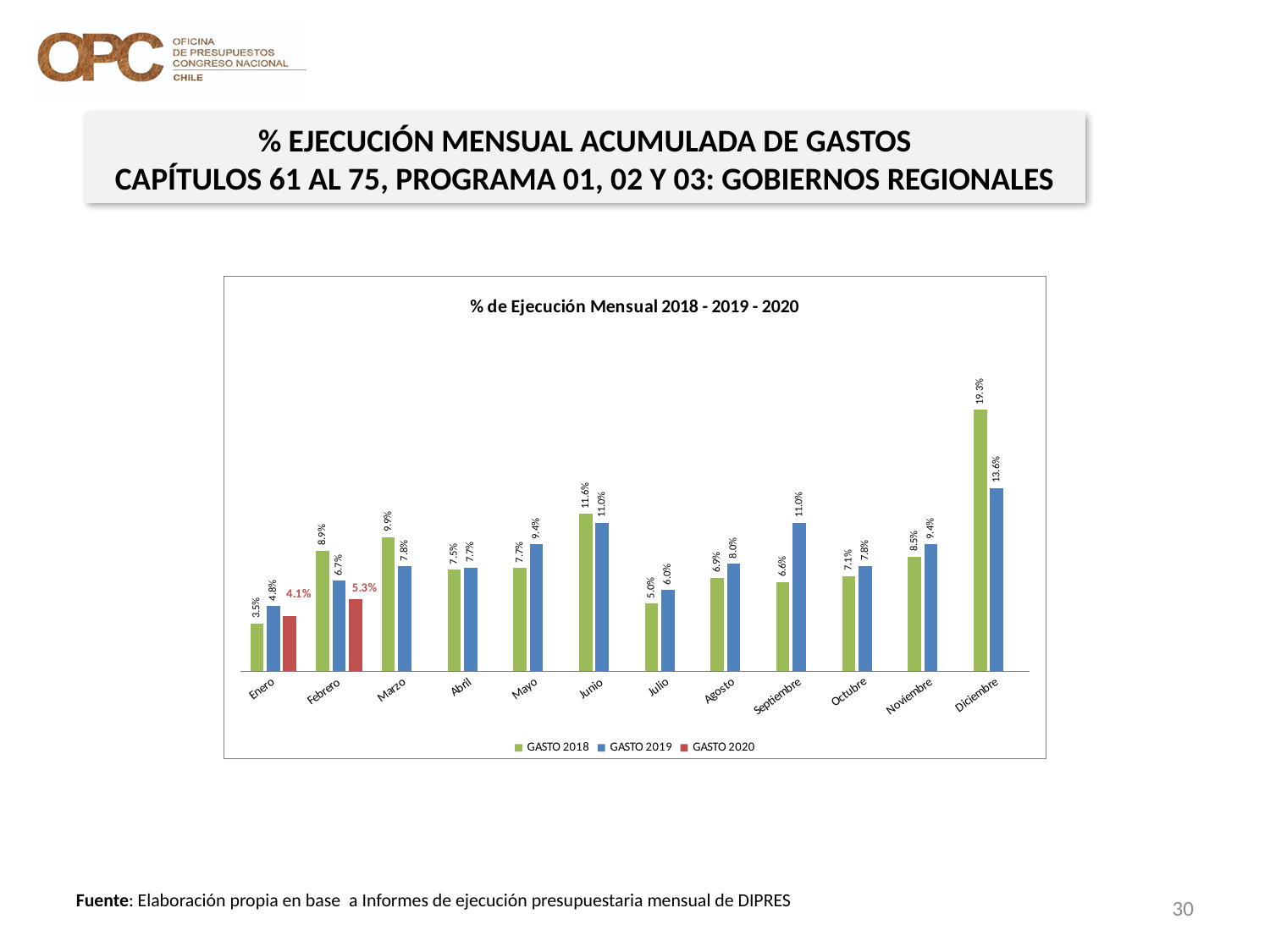
What is the difference between GASTO 2019 and GASTO 2018 in Septiembre? 4.4% How many months are shown on the x axis? 12 What is the value for GASTO 2018 in Diciembre? 19.3% Which month has the highest value for GASTO 2019? Diciembre What kind of chart is shown on the slide? Bar chart Which is larger in Febrero, GASTO 2018 or GASTO 2019? GASTO 2018 Which month has the lowest value for GASTO 2018? Enero What is the difference between GASTO 2018 and GASTO 2019 in Diciembre? 5.7% What is the title of the chart? % de Ejecución Mensual 2018 - 2019 - 2020 How many series does the legend list? 3 What is the value for GASTO 2019 in Septiembre? 11.0% What is the value for GASTO 2020 in Febrero? 5.3%